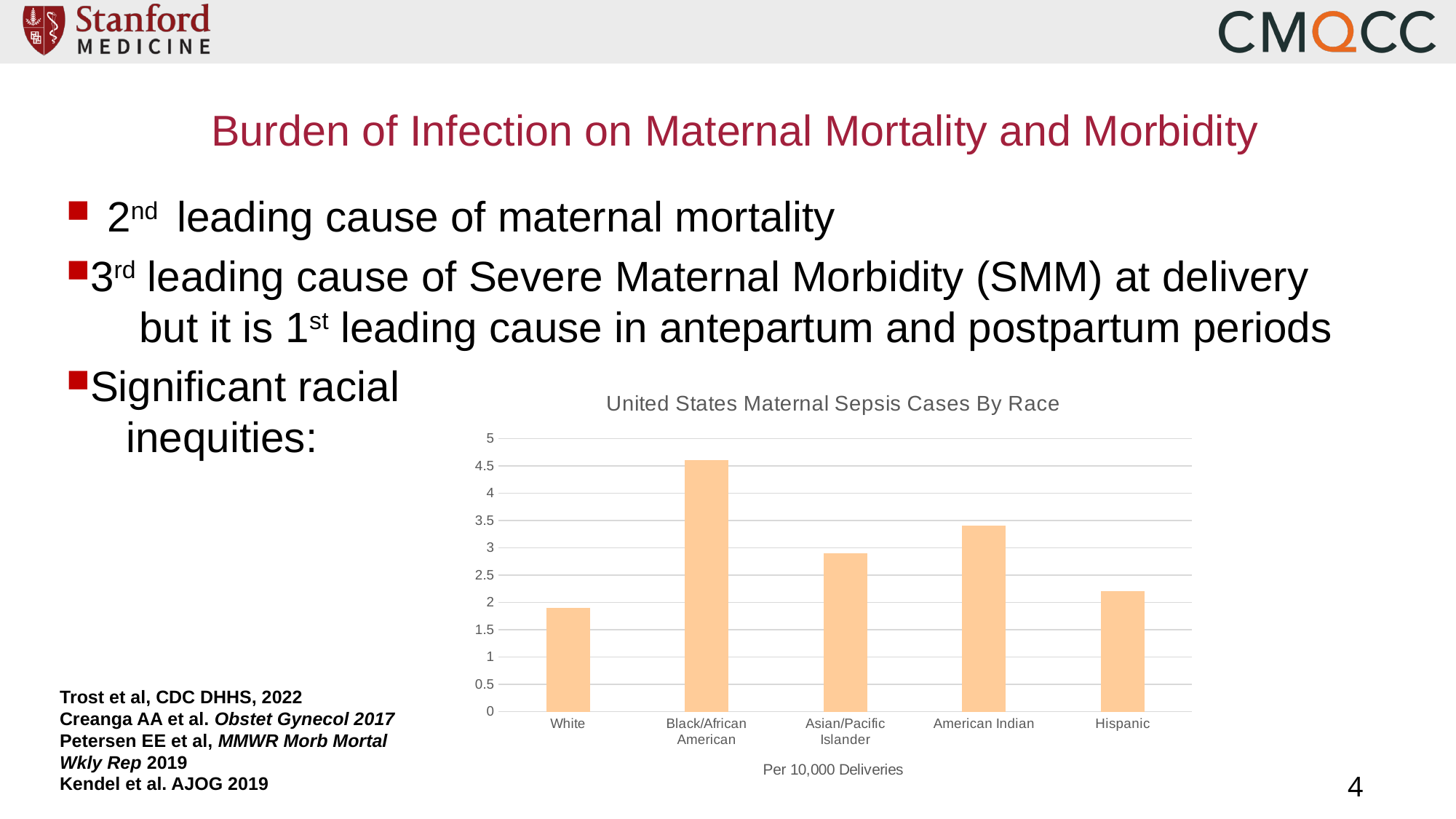
Is the value for White greater or less than 1.5? greater Which category has the lowest maternal sepsis rate in the chart? White Is the value for Black/African American greater or less than 4? greater Which is larger, the value for American Indian or the value for Asian/Pacific Islander? American Indian What is the title of the chart? United States Maternal Sepsis Cases By Race Which category has the highest maternal sepsis rate in the chart? Black/African American Is the value for American Indian greater or less than 3? greater What type of chart is shown on the slide? bar chart How many racial categories are plotted in the chart? 5 What unit is indicated below the x axis of the chart? Per 10,000 Deliveries